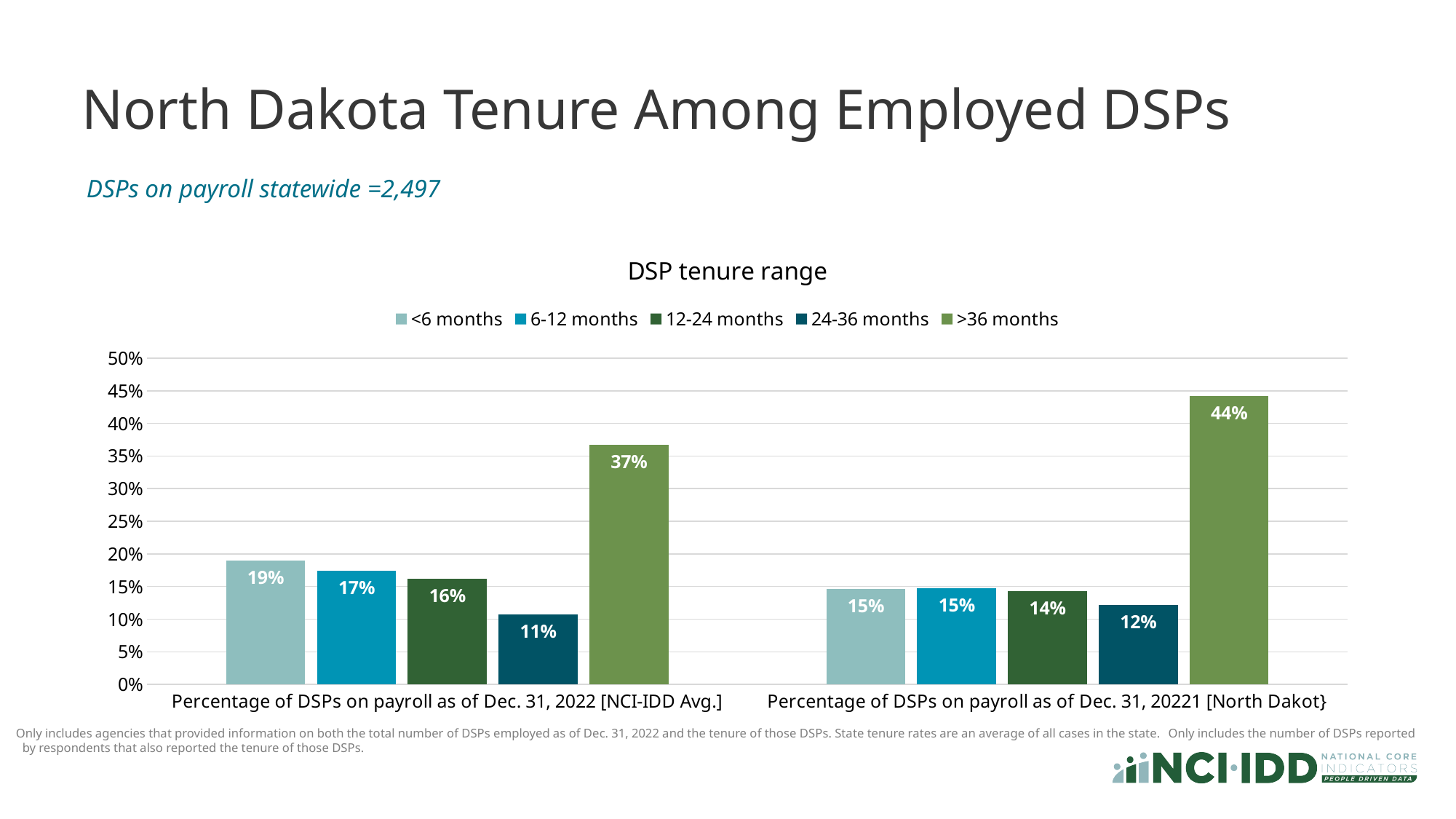
How many series does the legend list? 5 What is the difference between the >36 months values for North Dakota and the NCI-IDD Avg.? 7% What is the difference between the <6 months and 24-36 months values in the NCI-IDD Avg. group? 8% What is the value for <6 months in the NCI-IDD Avg. group? 19% What kind of chart is shown on the slide? Bar chart Is the value for >36 months in the North Dakota group greater or less than 40%? greater Which tenure range has the lowest value in the NCI-IDD Avg. group? 24-36 months What is the title of the chart? DSP tenure range Which tenure range has the highest value in the NCI-IDD Avg. group? >36 months What is the value for 24-36 months in the North Dakota group? 12% What is the value for >36 months in the North Dakota group? 44% Which is larger: the 12-24 months value for the NCI-IDD Avg. or for North Dakota? NCI-IDD Avg.